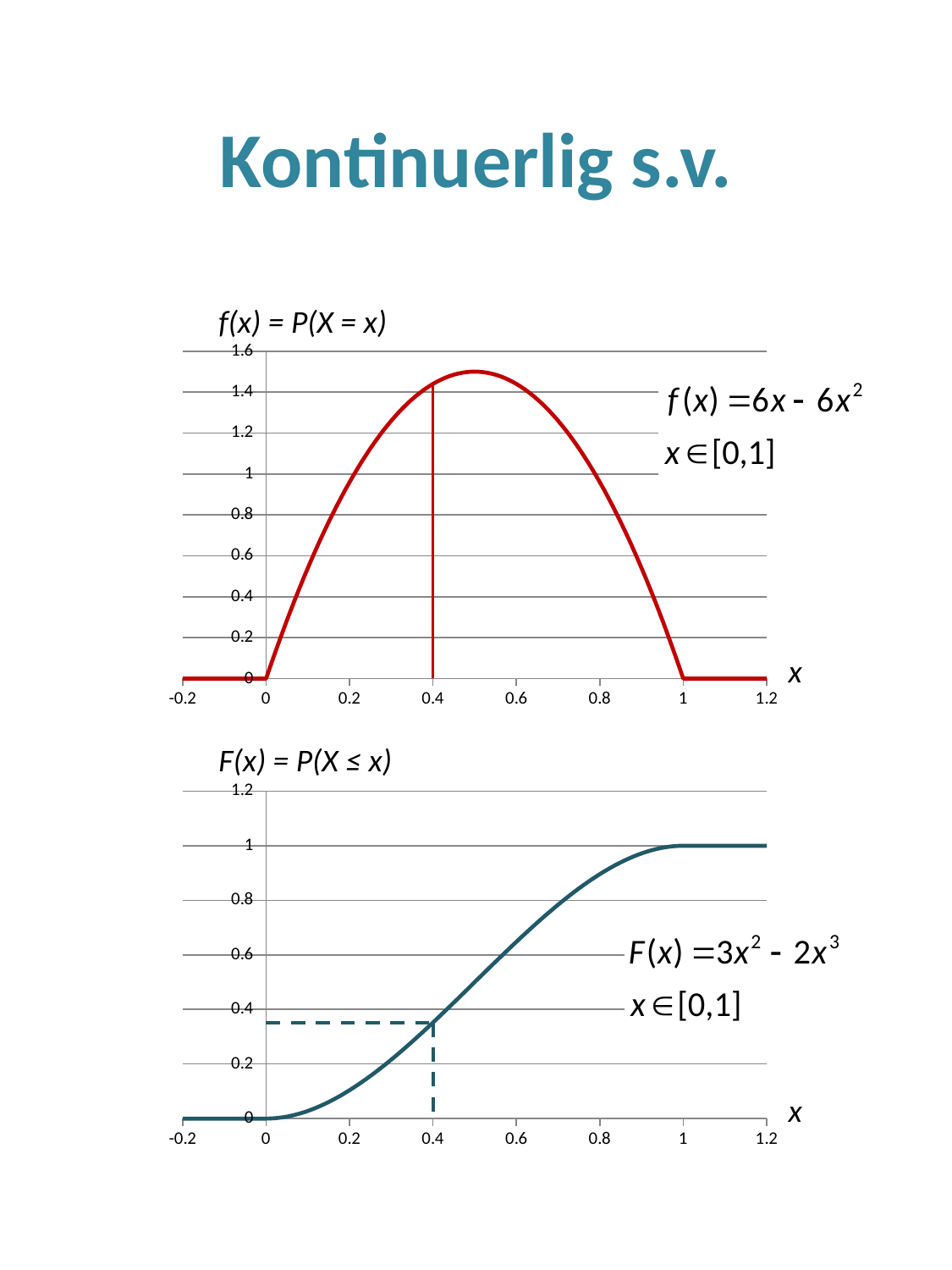
What kind of chart is the bottom chart, F(x) = P(X ≤ x)? line chart In the top chart f(x) = P(X = x), what is the value of the curve at x = 0? 0 In the top chart f(x) = P(X = x), which has the larger value: x = 0.4 or x = 0.8? x = 0.4 What kind of chart is the top chart, f(x) = P(X = x)? line chart In the bottom chart F(x) = P(X ≤ x), is the value at x = 0.8 greater or less than 0.8? greater In the bottom chart F(x) = P(X ≤ x), what value does the curve reach at x = 1? 1 In the top chart f(x) = P(X = x), is the value at x = 0.4 greater or less than 1.2? greater What formula is printed next to the top chart f(x) = P(X = x)? f(x) = 6x - 6x² In the top chart f(x) = P(X = x), does the curve rise or fall as x increases from 0.6 to 1? falls In the bottom chart F(x) = P(X ≤ x), is the value at x = 0.4 greater or less than 0.4? less In the bottom chart F(x) = P(X ≤ x), does the curve rise or fall as x increases from 0 to 1? rises